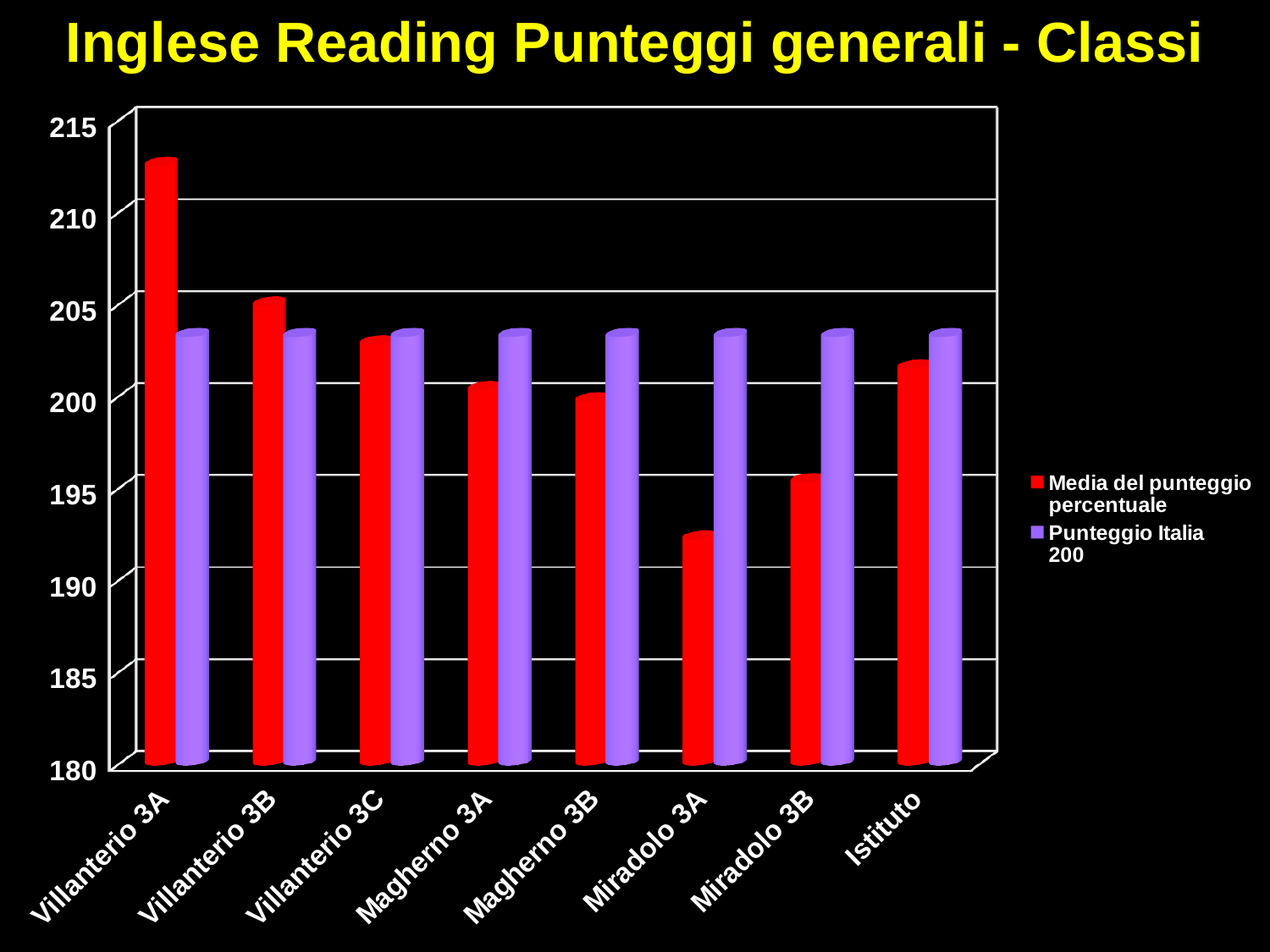
Is the Media del punteggio percentuale value for Villanterio 3B greater or less than 210? less How many series does the legend list? 2 Is the Media del punteggio percentuale value for Miradolo 3A greater or less than 190? greater Is the Media del punteggio percentuale value for Miradolo 3A greater or less than 195? less Which has the larger Media del punteggio percentuale value, Villanterio 3B or Magherno 3A? Villanterio 3B What is the title of the chart? Inglese Reading Punteggi generali - Classi Which series is shown in purple in the legend? Punteggio Italia 200 What kind of chart is shown on the slide? bar chart Which category has the lowest value for Media del punteggio percentuale? Miradolo 3A Which category has the highest value for Media del punteggio percentuale? Villanterio 3A How many categories are shown on the x axis? 8